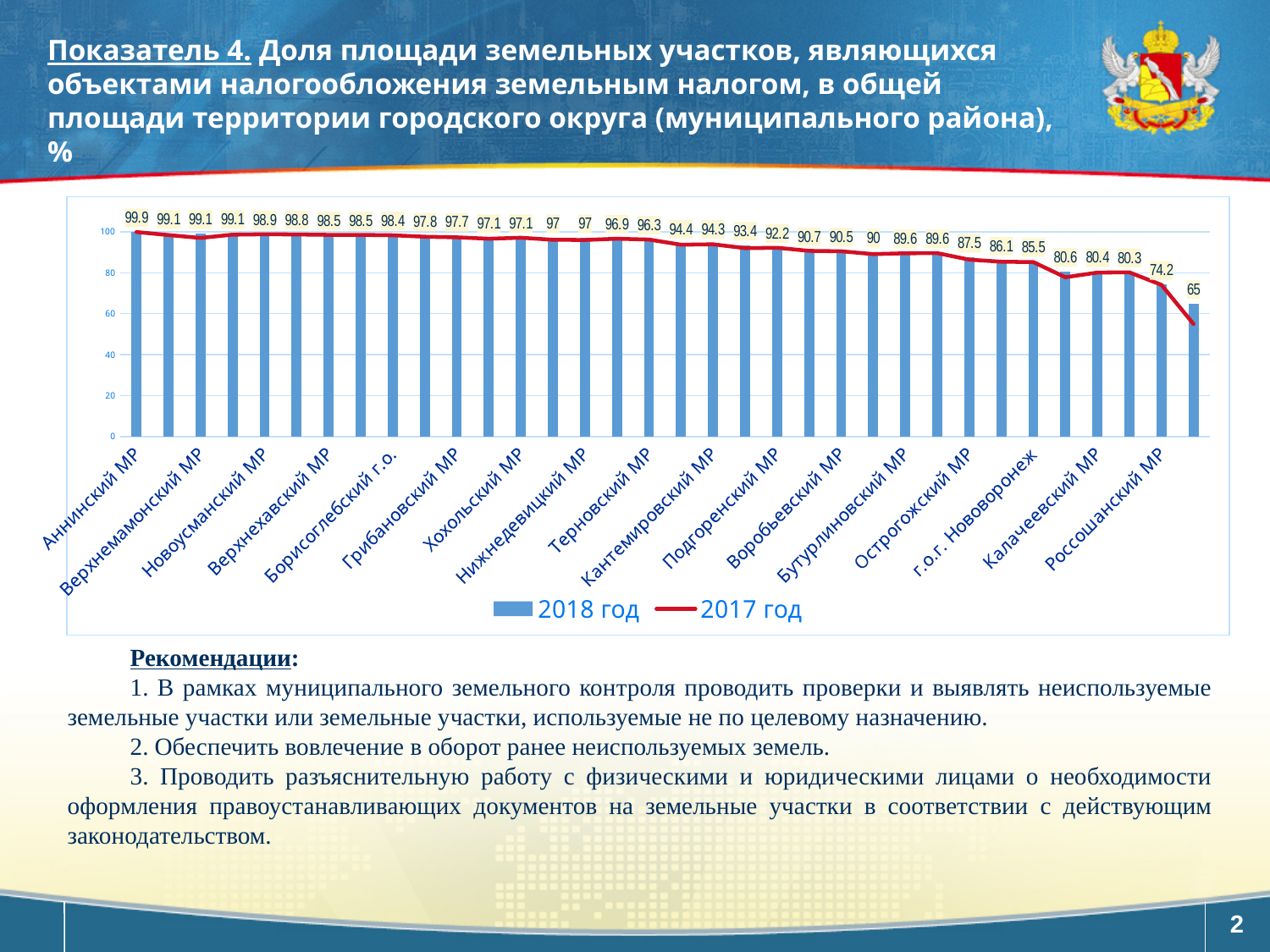
What is the 2018 value for Аннинский МР? 99.9 What are the two series named in the chart legend? 2018 год and 2017 год What is the highest 2018 value shown in the chart? 99.9 What type of chart is shown on the slide? bar chart with a line How many bars are plotted in the chart? 34 What colour are the bars representing 2018 год? blue What is the lowest 2018 value shown in the chart? 65 Do the 2018 bar values rise or fall from left to right along the x axis? fall How many series does the chart legend list? 2 What is the difference between the highest (99.9) and lowest (65) 2018 values in the chart? 34.9 Which is larger, the 2018 value for Аннинский МР or the lowest bar value of 65? Аннинский МР Is the 2017 line value for the last category on the right greater or less than 60? less